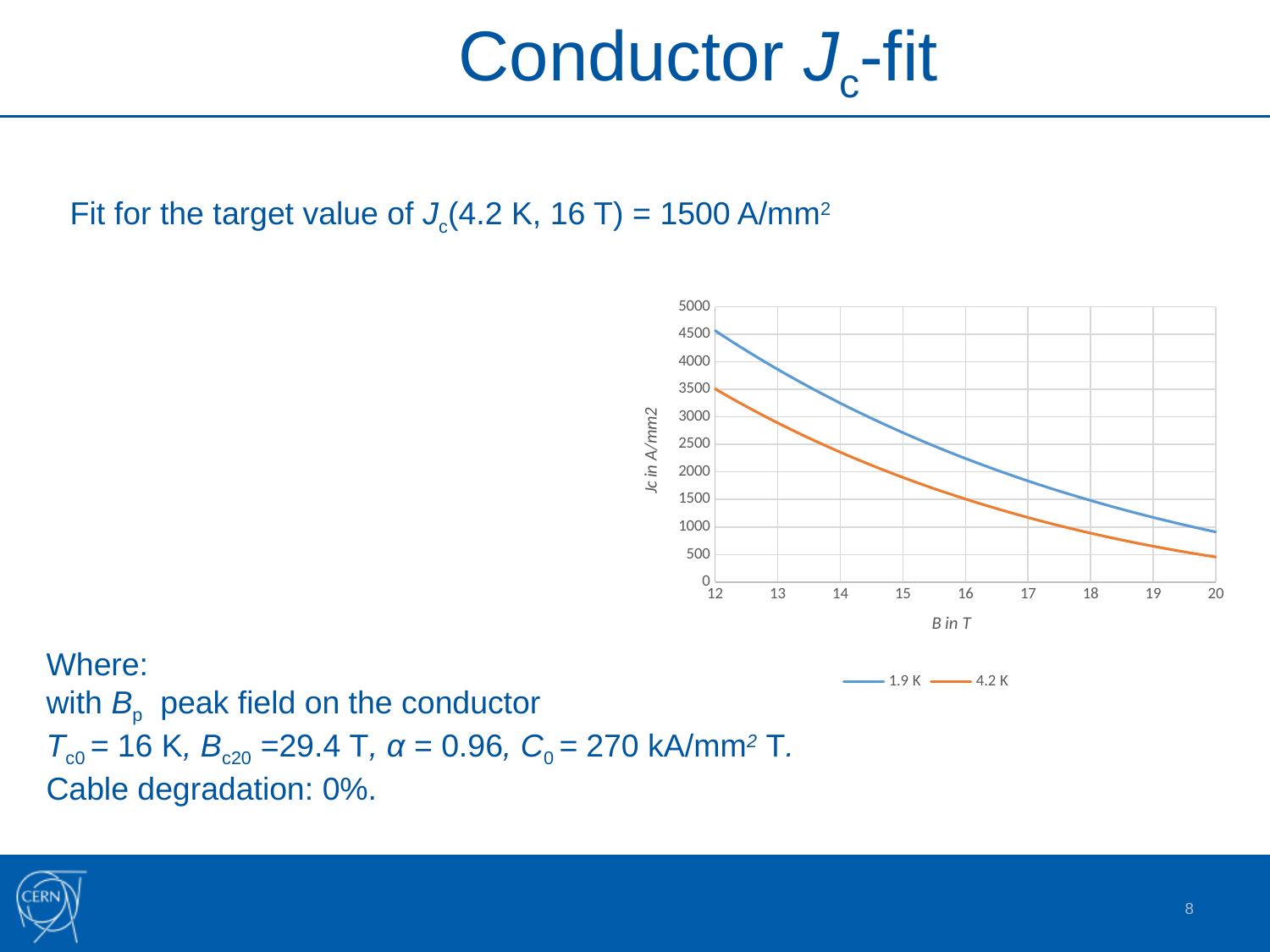
Is the Jc value of the 1.9 K curve at 20 T greater or less than 1000? less What is the Jc value of the 4.2 K curve at 16 T? 1500 A/mm2 Is the Jc value of the 1.9 K curve at 16 T greater or less than 2000? greater Do the Jc values rise or fall as B increases from 12 T to 20 T? fall Is the Jc value of the 4.2 K curve at 12 T greater or less than 3000? greater Which series has the higher Jc at 16 T, 1.9 K or 4.2 K? 1.9 K What are the two series named in the chart legend? 1.9 K and 4.2 K How many series does the chart legend list? 2 What is the label of the x axis of the chart? B in T What kind of chart is shown on the slide? line chart